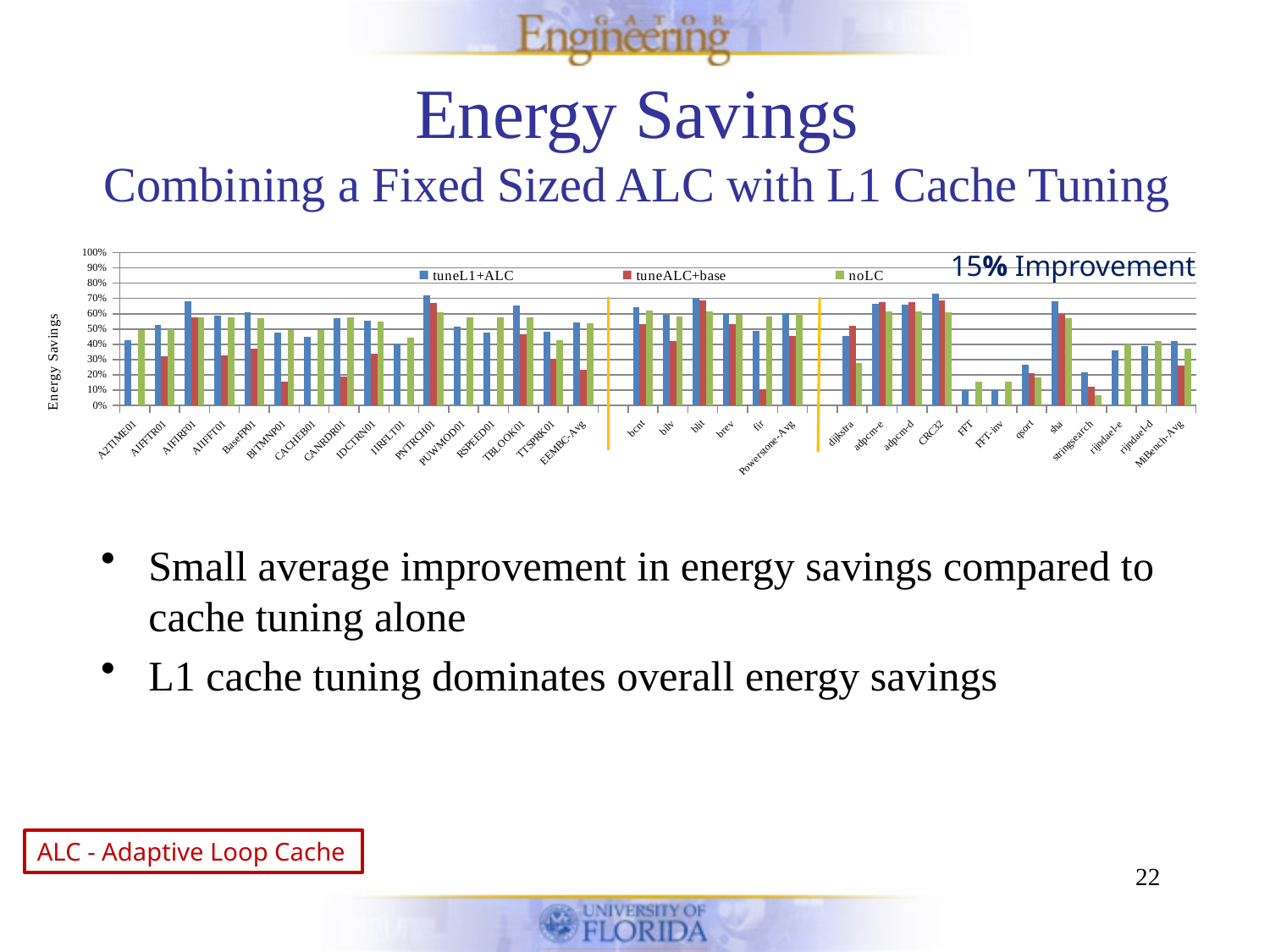
What kind of chart is shown on the slide? bar chart What is the label on the vertical axis of the chart? Energy Savings Is the tuneALC+base value for fir greater or less than 30%? less Is the tuneALC+base value for BITMNP01 greater or less than 30%? less Is the tuneL1+ALC value for PNTRCH01 greater or less than 60%? greater For AIFFTR01, which is larger: the tuneL1+ALC value or the tuneALC+base value? tuneL1+ALC What are the three series named in the chart legend? tuneL1+ALC, tuneALC+base, noLC For PNTRCH01, which series has the highest value? tuneL1+ALC How many series does the chart legend list? 3 For BITMNP01, which is larger: the tuneL1+ALC value or the tuneALC+base value? tuneL1+ALC